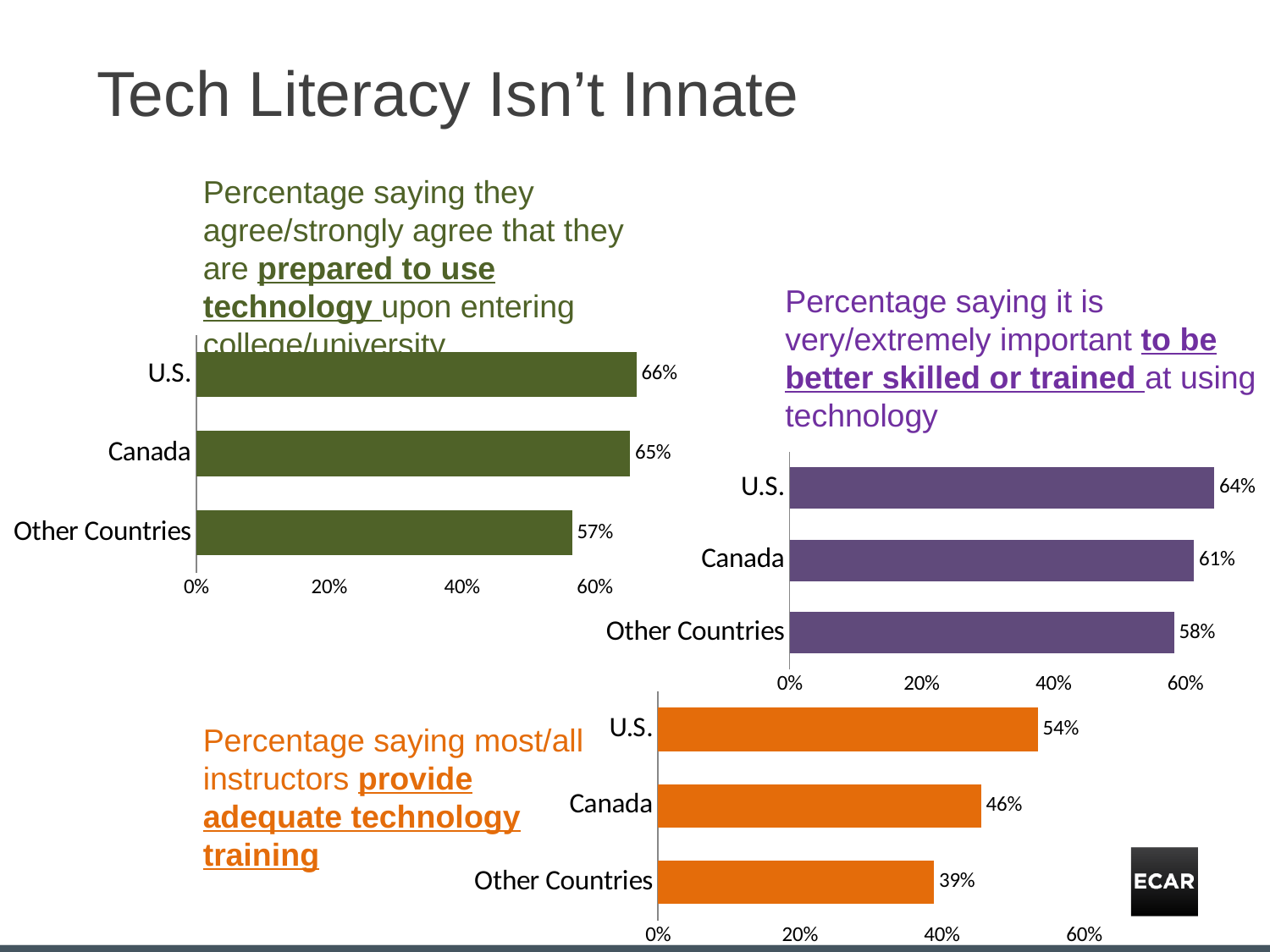
In the purple chart (better skilled or trained), which category has the highest value? U.S. In the orange chart (provide adequate technology training), what is the value for U.S.? 54% In the orange chart (provide adequate technology training), is the value for Other Countries greater or less than 40%? less In the green chart (prepared to use technology), what is the value for Canada? 65% In the green chart (prepared to use technology), what is the difference between the U.S. and Other Countries values? 9% In the purple chart (better skilled or trained), which is larger, the value for Canada or the value for Other Countries? Canada How many categories does the green chart (prepared to use technology) show? 3 What type of chart is the purple chart (better skilled or trained)? bar chart How many charts are on the slide? 3 In the orange chart (provide adequate technology training), which category has the lowest value? Other Countries In the orange chart (provide adequate technology training), what is the difference between the U.S. and Canada values? 8% In the purple chart (better skilled or trained), what is the value for Other Countries? 58%